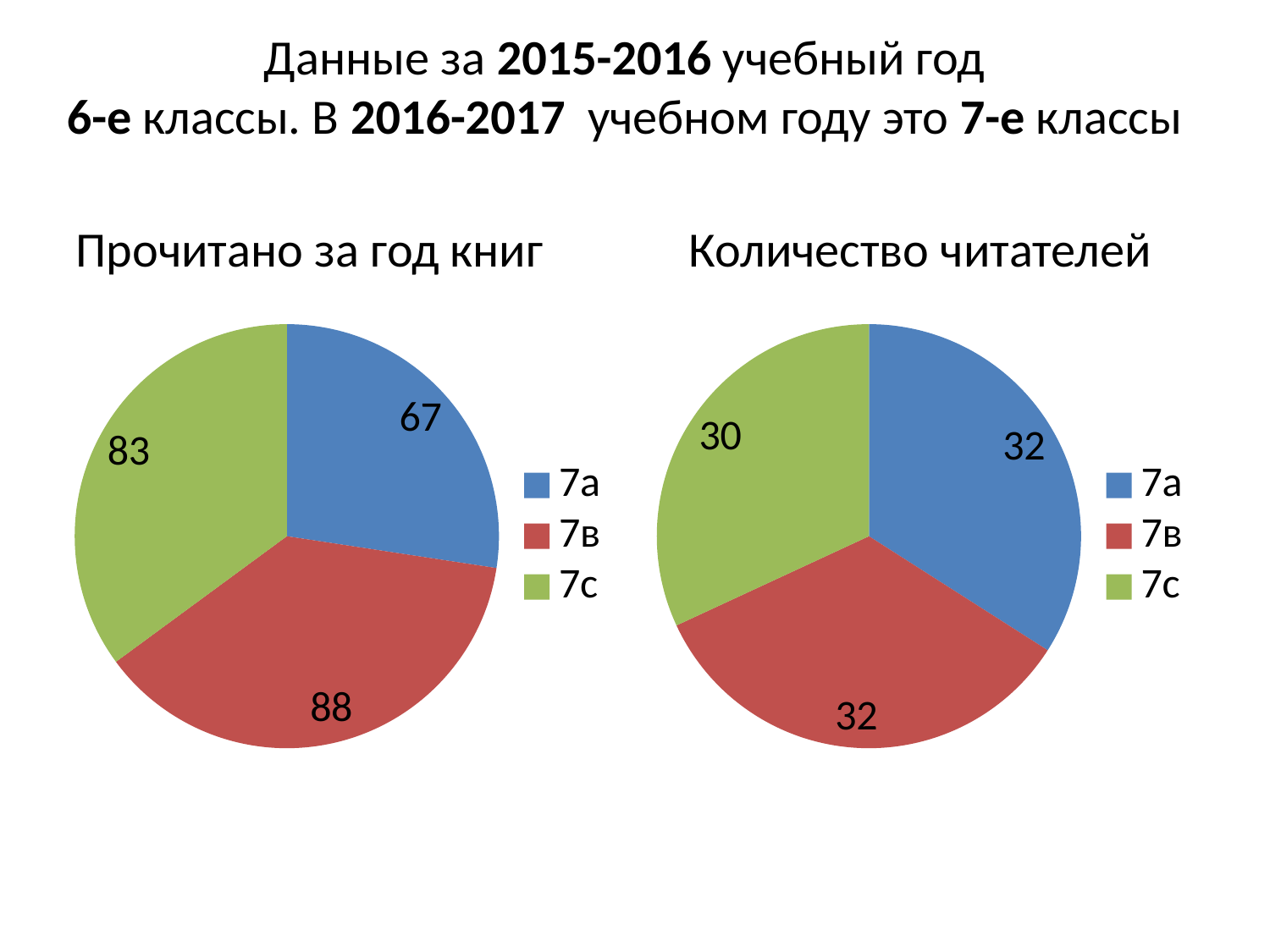
In the chart titled "Количество читателей", which category has the lowest value? 7с In the chart titled "Прочитано за год книг", which category has the lowest value? 7а How many slices does the chart titled "Количество читателей" have? 3 In the chart titled "Количество читателей", what is the difference between the values for 7а and 7с? 2 In the chart titled "Прочитано за год книг", what is the value for 7а? 67 What kind of chart is the chart titled "Прочитано за год книг"? pie chart In the chart titled "Прочитано за год книг", what is the difference between the values for 7в and 7с? 5 In the chart titled "Количество читателей", what is the value for 7с? 30 In the chart titled "Количество читателей", what colour is the slice for 7в? red In the chart titled "Прочитано за год книг", what is the value for 7в? 88 In the chart titled "Прочитано за год книг", which is larger, the value for 7с or the value for 7а? 7с In the chart titled "Прочитано за год книг", which category has the highest value? 7в